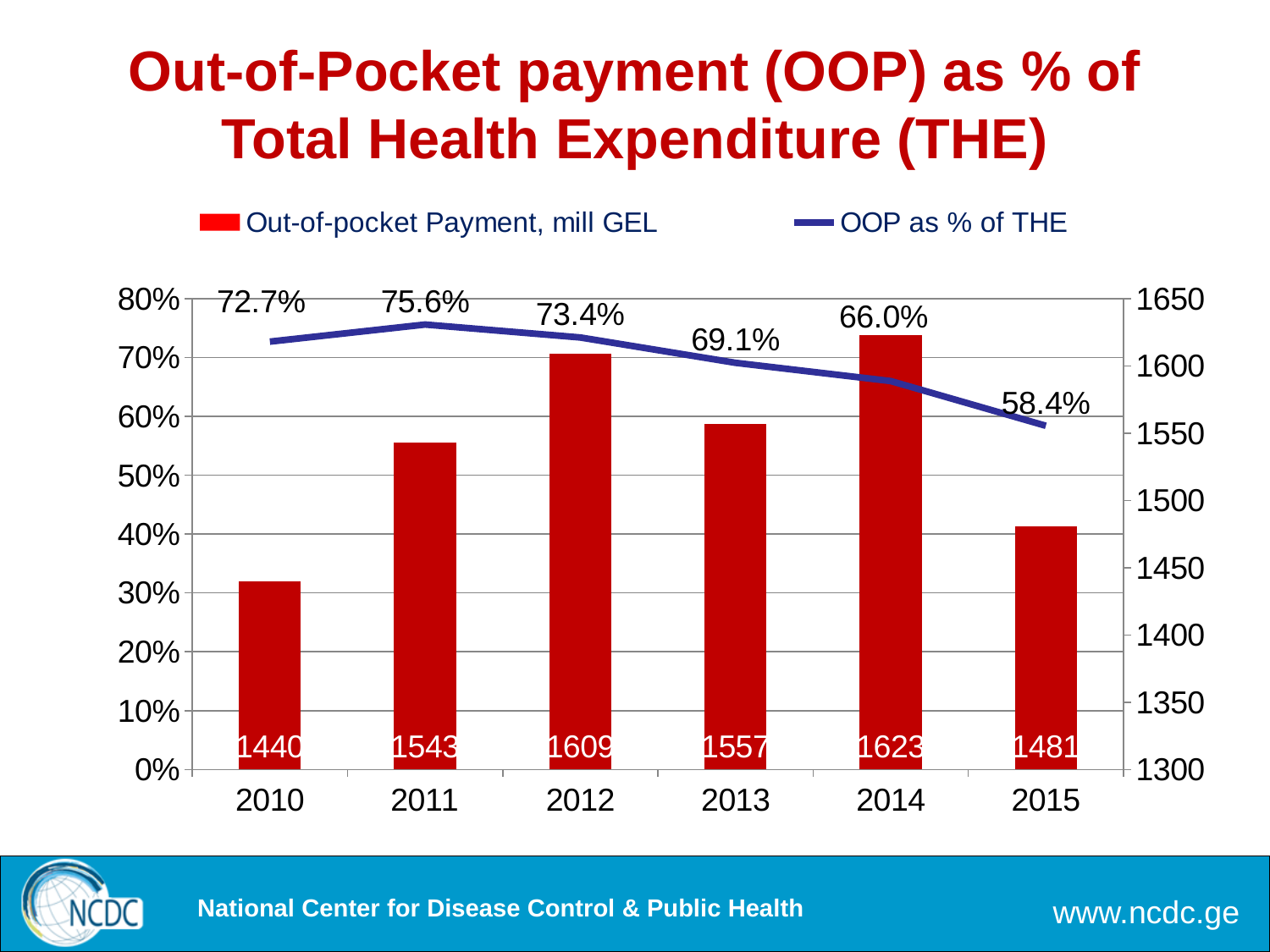
Which year had a larger Out-of-pocket Payment in mill GEL, 2011 or 2013? 2013 What was the Out-of-pocket Payment in mill GEL in 2012? 1609 What is the difference in Out-of-pocket Payment (mill GEL) between 2014 and 2010? 183 In which year was the Out-of-pocket Payment in mill GEL highest? 2014 How many series does the legend list? 2 How many years are shown on the x axis of the chart? 6 What colour are the bars for Out-of-pocket Payment, mill GEL? Red What was OOP as % of THE in 2014? 66.0% What is the general trend of OOP as % of THE from 2011 to 2015? Falling In which year was OOP as % of THE lowest? 2015 In which year was OOP as % of THE highest? 2011 By how many percentage points did OOP as % of THE fall from 2011 to 2015? 17.2